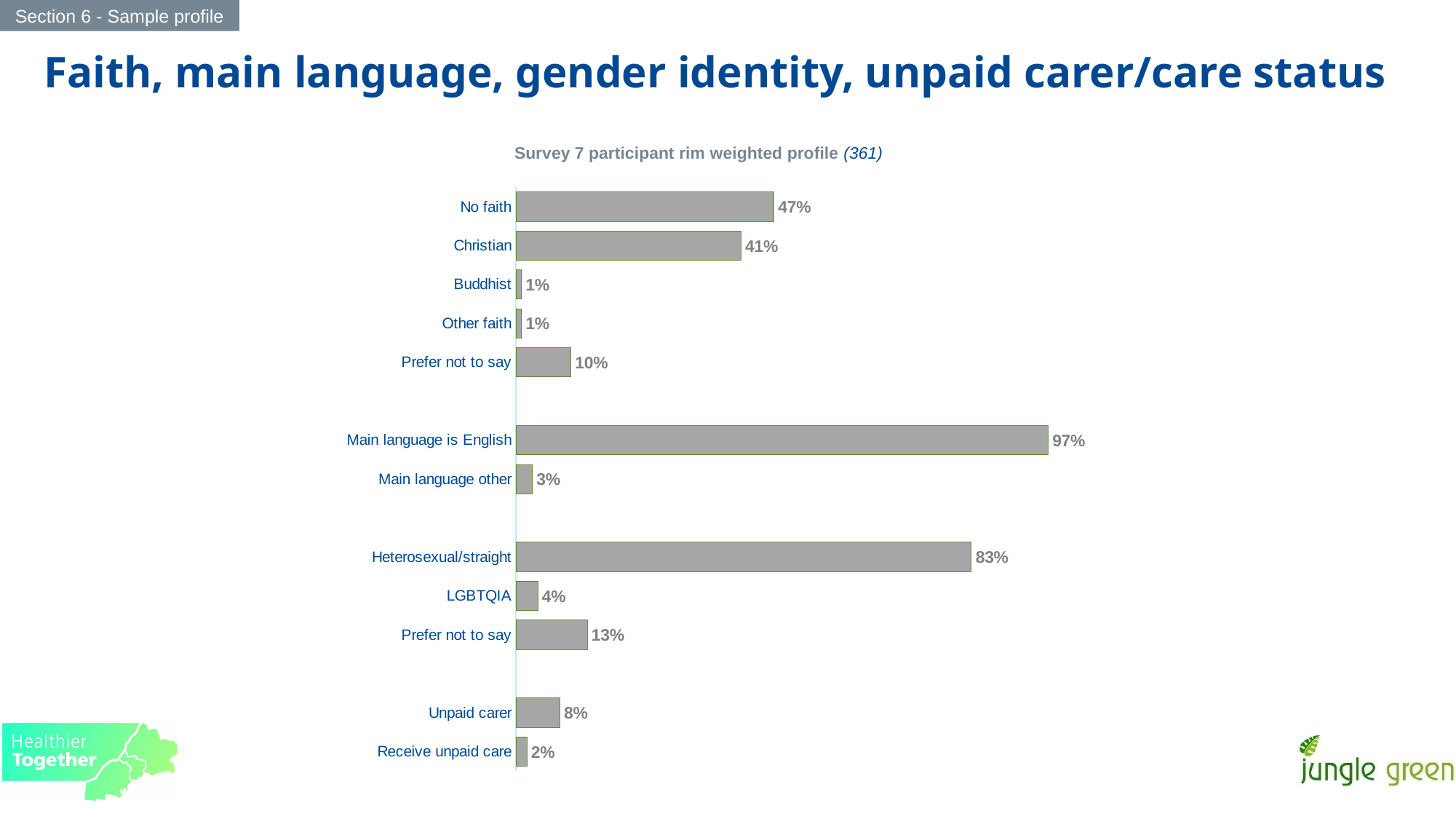
What is the value for Main language is English? 97% What is the title of the chart? Survey 7 participant rim weighted profile (361) Which is larger, the value for LGBTQIA or the value for Unpaid carer? Unpaid carer What is the difference between Main language is English and Main language other? 94% What is the value for Receive unpaid care? 2% What is the value for Heterosexual/straight? 83% What percentage of participants are unpaid carers? 8% What percentage of participants have no faith? 47% What is the difference between the No faith and Christian values? 6% How many categories (bars) are shown on the chart? 12 Which category has the highest value on the chart? Main language is English What kind of chart is shown on the slide? Bar chart